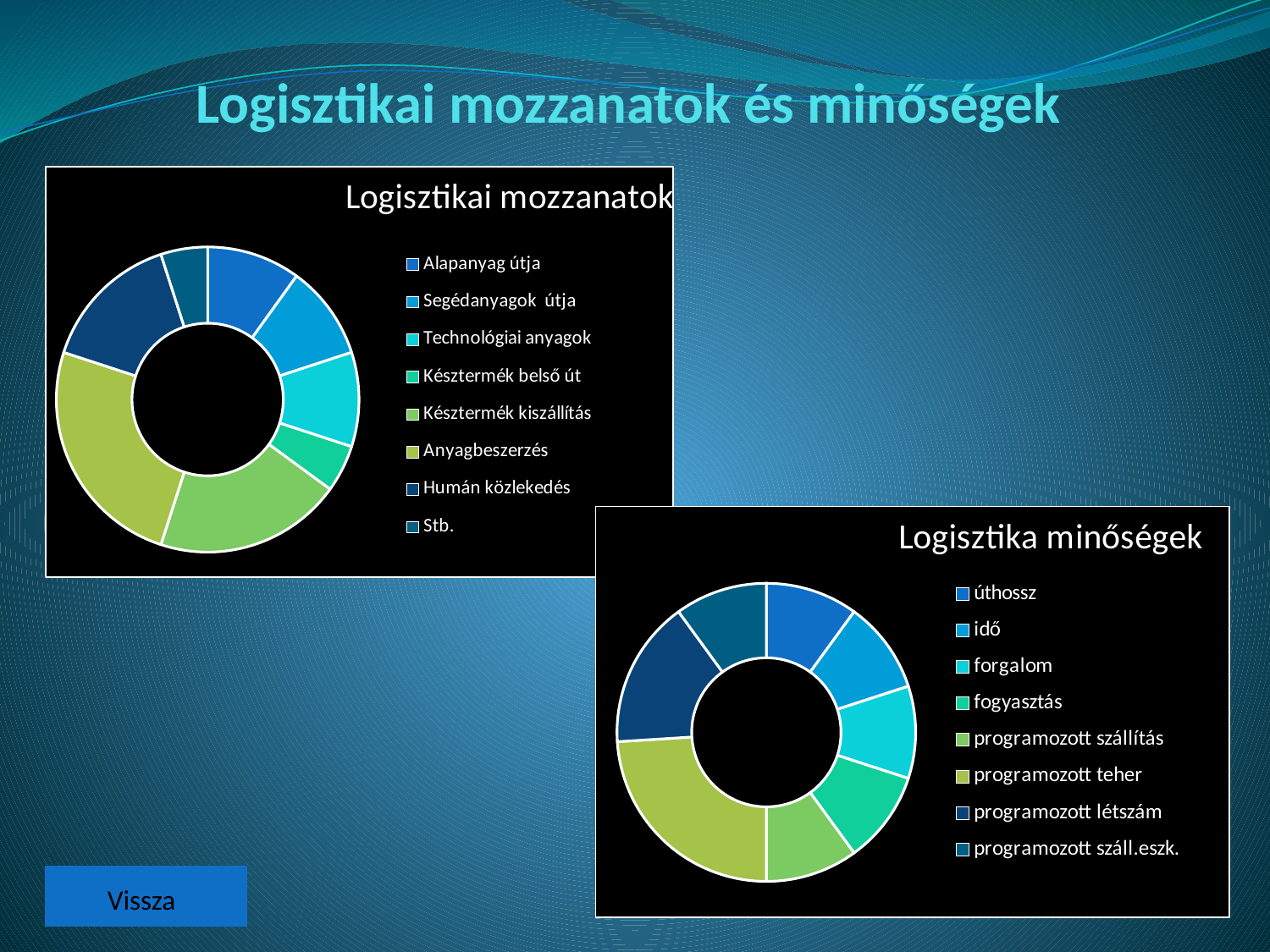
In the 'Logisztikai mozzanatok' chart, which slice is larger: Késztermék kiszállítás or Késztermék belső út? Késztermék kiszállítás In the 'Logisztikai mozzanatok' chart, which slice is larger: Anyagbeszerzés or Stb.? Anyagbeszerzés How many categories does the legend of the 'Logisztika minőségek' chart list? 8 In the 'Logisztika minőségek' chart, which slice is larger: programozott teher or idő? programozott teher In the 'Logisztikai mozzanatok' chart, which category has the largest slice? Anyagbeszerzés What is the last legend entry of the 'Logisztikai mozzanatok' chart? Stb. What is the title of the chart in the lower right of the slide? Logisztika minőségek What kind of chart is the 'Logisztikai mozzanatok' chart? doughnut chart What kind of chart is the 'Logisztika minőségek' chart? doughnut chart In the 'Logisztika minőségek' chart, which category has the largest slice? programozott teher How many categories does the legend of the 'Logisztikai mozzanatok' chart list? 8